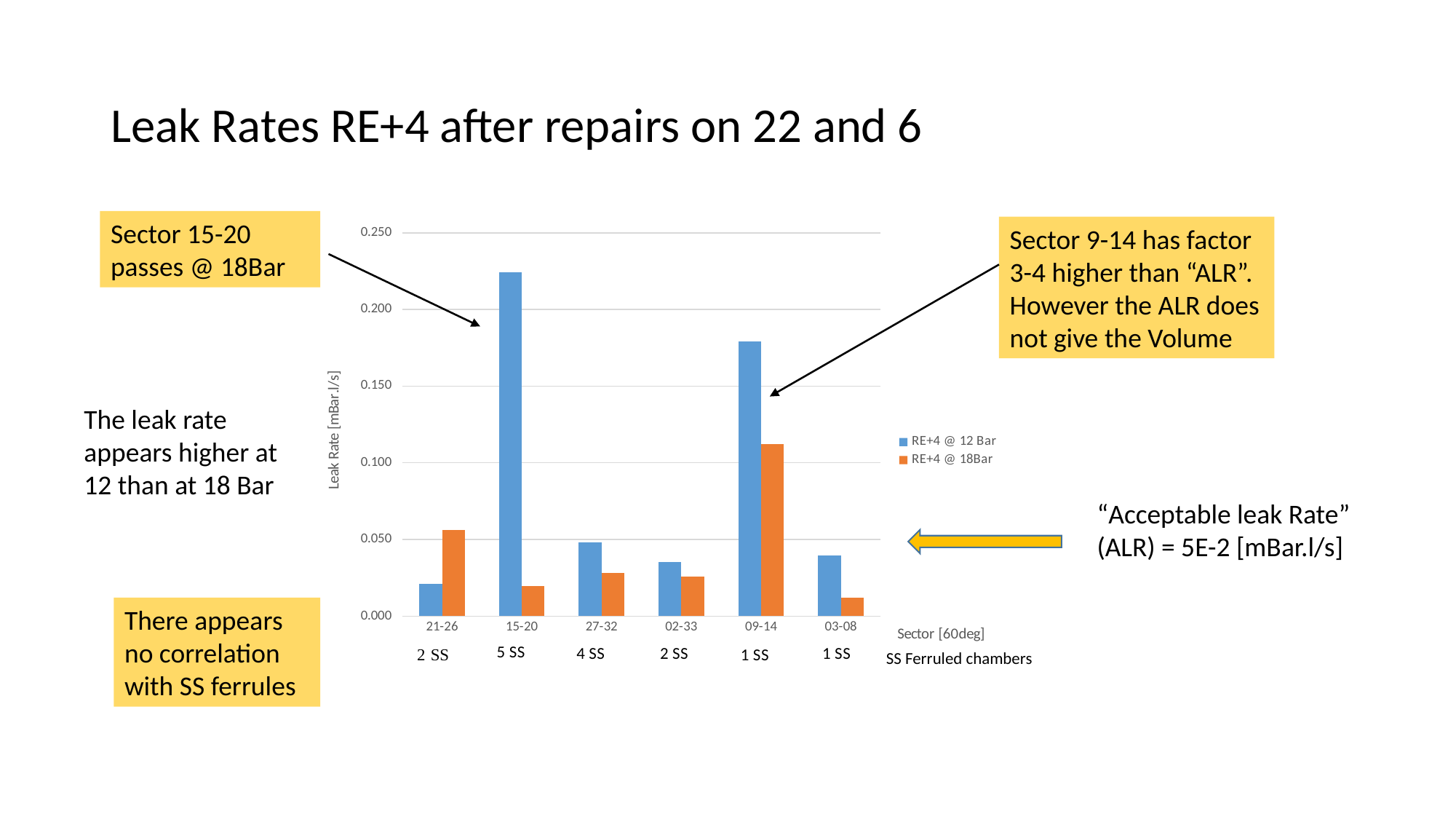
Which sector has the lowest leak rate for RE+4 @ 12 Bar? 21-26 What is the label of the chart's vertical axis? Leak Rate [mBar.l/s] For sector 21-26, which is larger: the leak rate at RE+4 @ 12 Bar or at RE+4 @ 18Bar? RE+4 @ 18Bar What kind of chart is shown on the slide? bar chart Which sector has the lowest leak rate for RE+4 @ 18Bar? 03-08 Is the RE+4 @ 18Bar value for sector 09-14 greater or less than 0.100? greater Which sector has the highest leak rate for RE+4 @ 18Bar? 09-14 Is the RE+4 @ 12 Bar value for sector 15-20 greater or less than 0.200? greater How many sectors are shown on the x axis of the chart? 6 Which sector has the highest leak rate for RE+4 @ 12 Bar? 15-20 How many series does the chart legend list? 2 For sector 15-20, which is larger: the leak rate at RE+4 @ 12 Bar or at RE+4 @ 18Bar? RE+4 @ 12 Bar